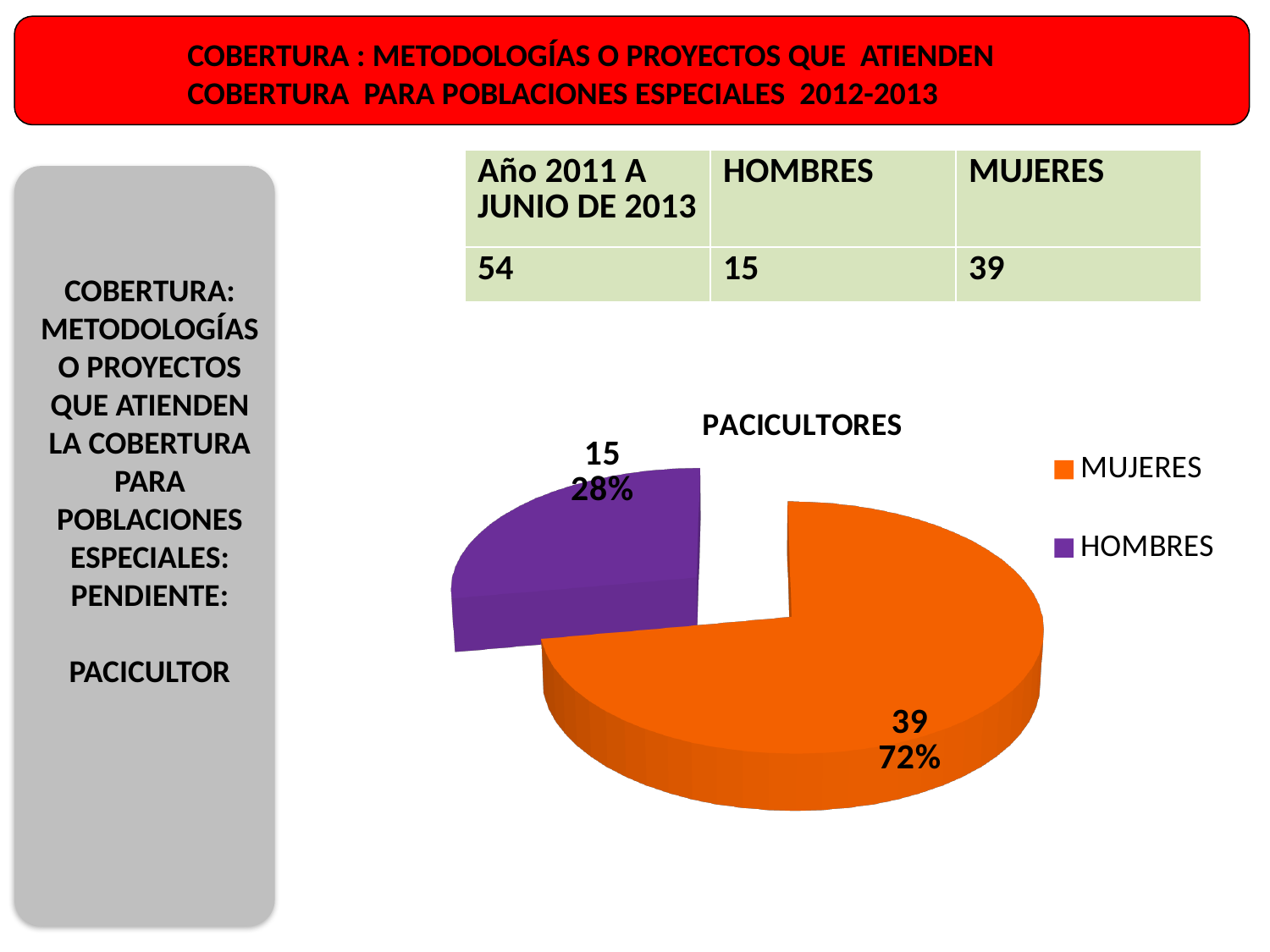
What is the total of the two slices in the PACICULTORES pie chart? 54 Which category has the largest slice in the PACICULTORES pie chart? MUJERES What colour is the MUJERES slice in the PACICULTORES pie chart? orange What is the value for MUJERES in the PACICULTORES pie chart? 39 What is the difference between the MUJERES and HOMBRES values in the PACICULTORES pie chart? 24 What percentage share does HOMBRES have in the PACICULTORES pie chart? 28% What percentage share does MUJERES have in the PACICULTORES pie chart? 72% Which is larger in the PACICULTORES pie chart, MUJERES or HOMBRES? MUJERES How many slices does the PACICULTORES pie chart have? 2 What type of chart is shown under the title PACICULTORES? pie chart What is the value for HOMBRES in the PACICULTORES pie chart? 15 Which category has the smallest slice in the PACICULTORES pie chart? HOMBRES